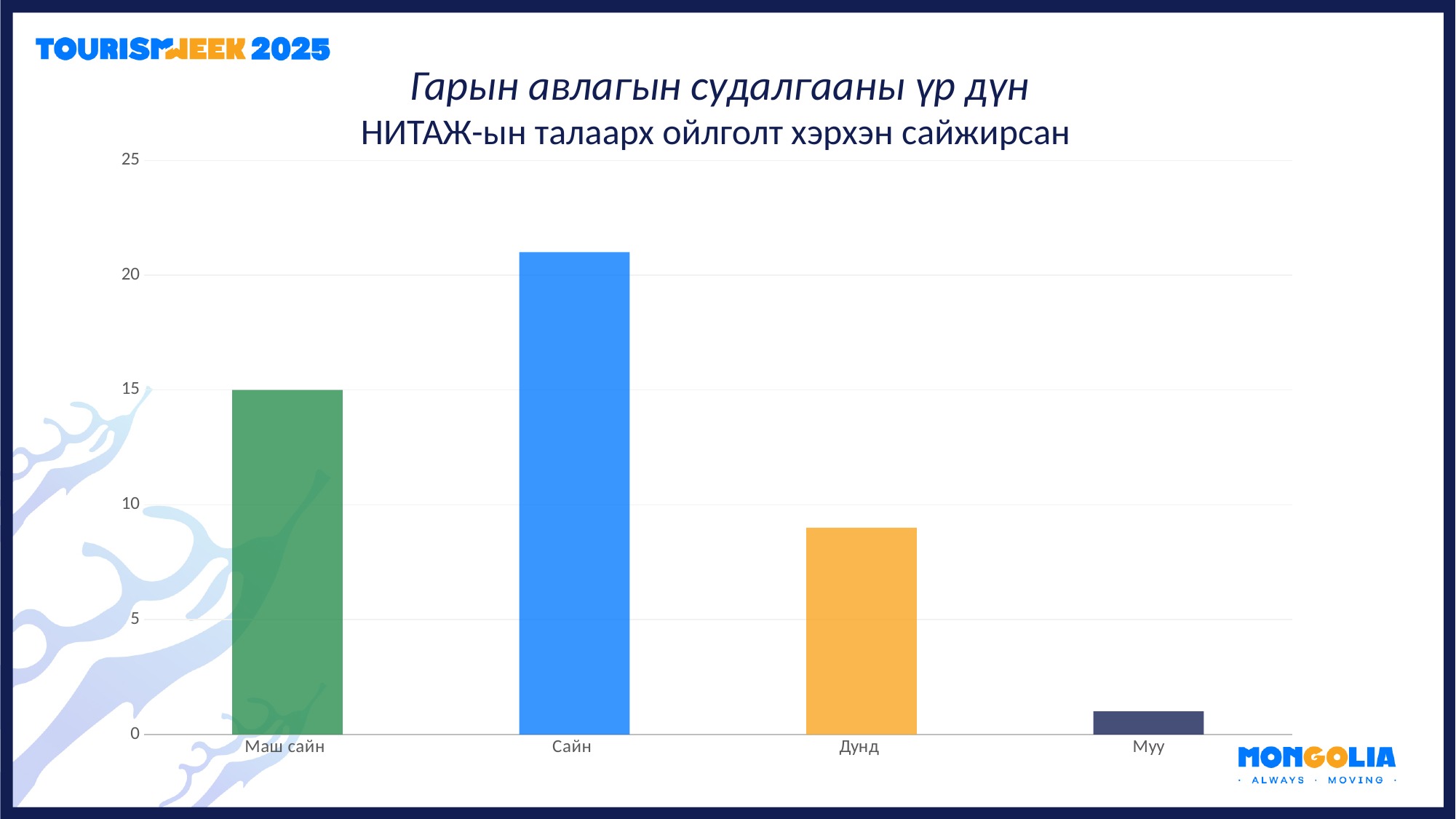
Which is larger, the value for Сайн or the value for Маш сайн? Сайн Which is larger, the value for Маш сайн or the value for Дунд? Маш сайн What is the value for Маш сайн in the chart? 15 Which category has the lowest bar in the chart? Муу What kind of chart is shown on the slide? bar chart Is the value for Муу greater or less than 5? less How many categories are shown on the x axis of the chart? 4 What colour is the bar for Дунд? orange Is the value for Дунд greater or less than 10? less Which category has the highest bar in the chart? Сайн Is the value for Сайн greater or less than 20? greater